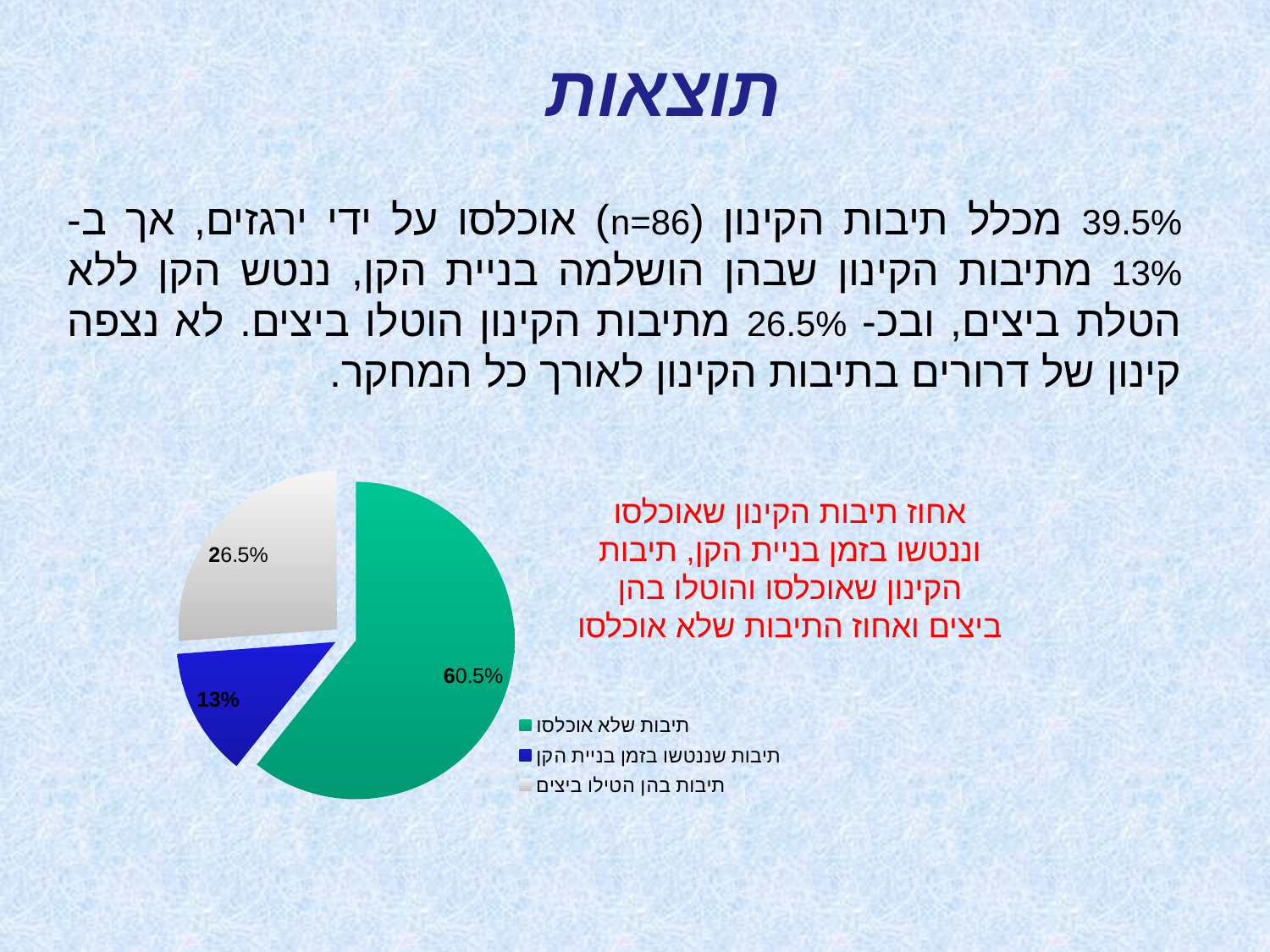
What colour is the slice for 'תיבות שננטשו בזמן בניית הקן'? blue What is the value of the slice labelled 'תיבות שלא אוכלסו'? 60.5% How many entries does the legend of the pie chart list? 3 How many slices does the pie chart have? 3 What is the value of the slice labelled 'תיבות בהן הטילו ביצים'? 26.5% Which category has the largest slice of the pie chart? תיבות שלא אוכלסו What is the difference between the 'תיבות שלא אוכלסו' slice and the 'תיבות בהן הטילו ביצים' slice? 34% What kind of chart is shown on the slide? pie chart What is the value of the slice labelled 'תיבות שננטשו בזמן בניית הקן'? 13% Which category has the smallest slice of the pie chart? תיבות שננטשו בזמן בניית הקן Which is larger: the 'תיבות בהן הטילו ביצים' slice or the 'תיבות שננטשו בזמן בניית הקן' slice? תיבות בהן הטילו ביצים What colour is the largest slice of the pie chart? green